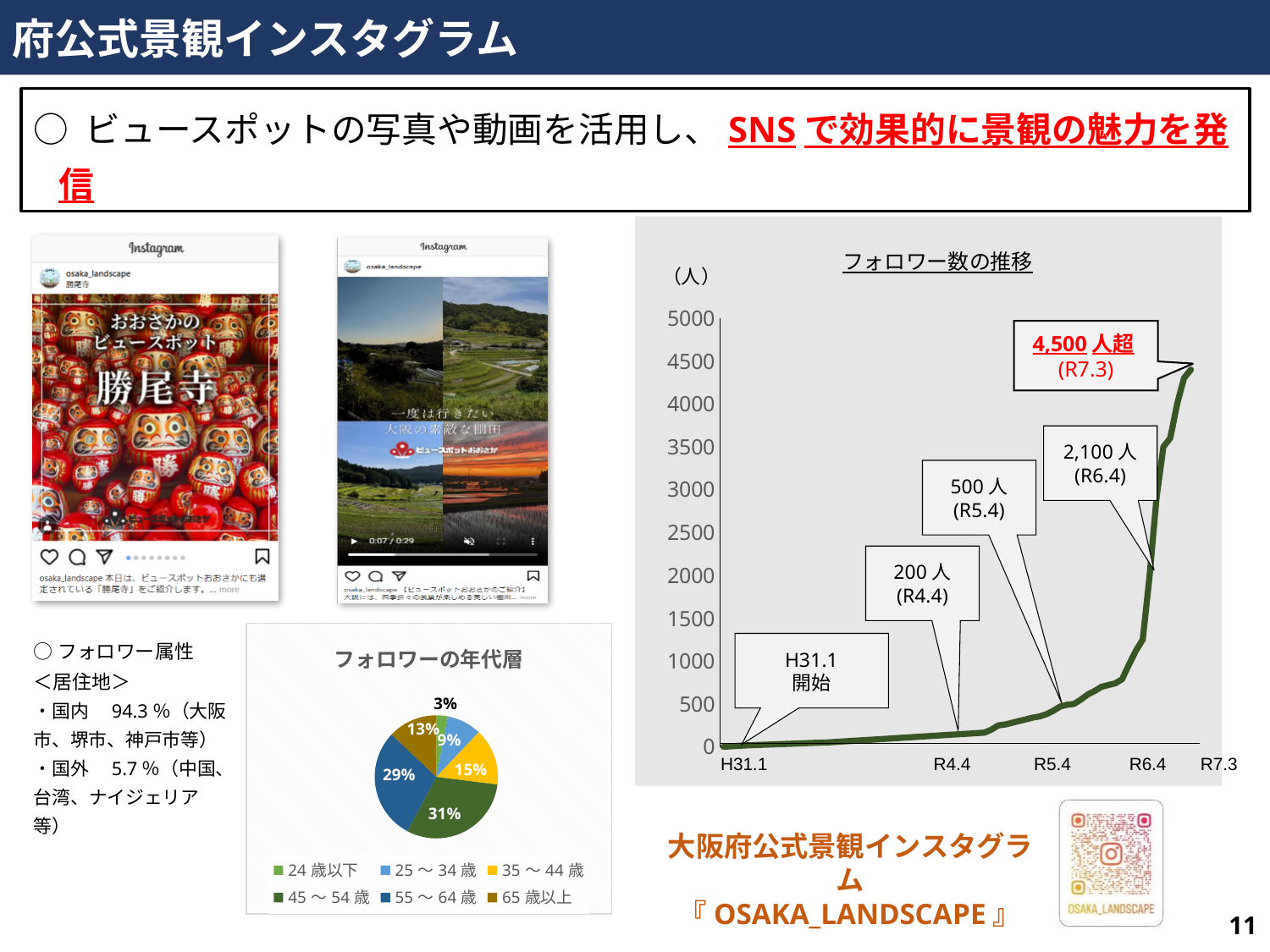
How many age groups are shown in the pie chart titled フォロワーの年代層? 6 In the line chart titled フォロワー数の推移, is the value at R7.3 greater or less than 4000? greater In the line chart titled フォロワー数の推移, what was the follower count at R6.4? 2,100人 What kind of chart is the one titled フォロワー数の推移? Line chart In the line chart titled フォロワー数の推移, do the values rise or fall from H31.1 to R7.3? Rise In the pie chart titled フォロワーの年代層, which age group has the largest share? 45〜54歳 In the pie chart titled フォロワーの年代層, which is larger: the share for 25〜34歳 or for 35〜44歳? 35〜44歳 In the pie chart titled フォロワーの年代層, what is the difference in percentage points between 45〜54歳 and 65歳以上? 18 In the pie chart titled フォロワーの年代層, what share of followers are 45〜54歳? 31% In the line chart titled フォロワー数の推移, what was the follower count at R5.4? 500人 In the pie chart titled フォロワーの年代層, which age group has the smallest share? 24歳以下 What kind of chart is the one titled フォロワーの年代層? Pie chart